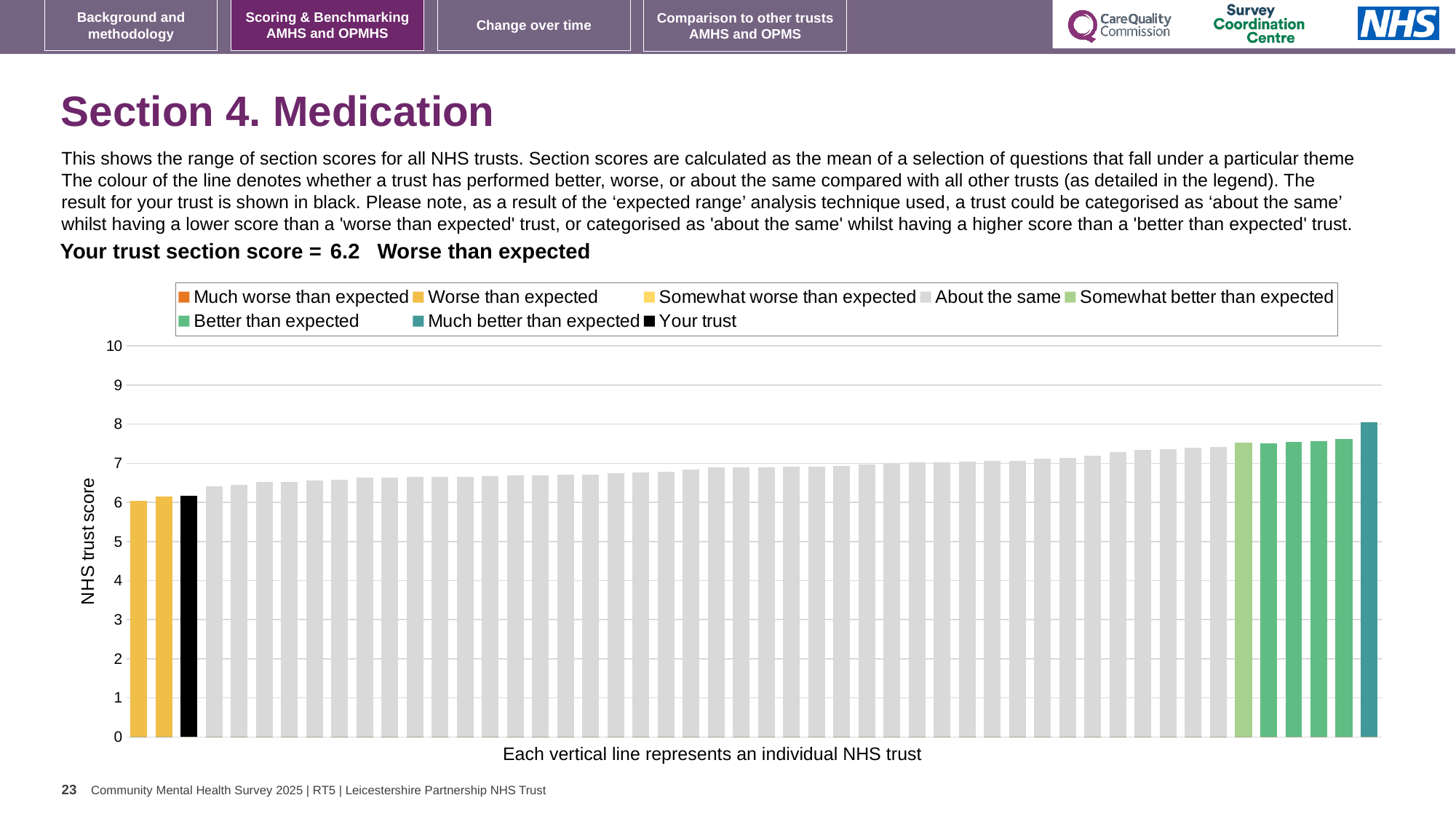
What kind of chart is shown on the slide? Bar chart Is the value for your trust greater or less than 5? greater Which performance category is your trust's section score assigned to? Worse than expected Do the bar values rise or fall from left to right along the x axis? Rise What is the label on the vertical axis? NHS trust score What colour is the bar representing your trust? Black Which legend category does the tallest bar belong to? Much better than expected How many entries does the chart legend list? 8 Is the value of the tallest bar greater or less than 7? greater Is the value of the shortest bar greater or less than 7? less What is the section score for your trust shown on the slide? 6.2 How many bars are coloured as 'Worse than expected'? 2